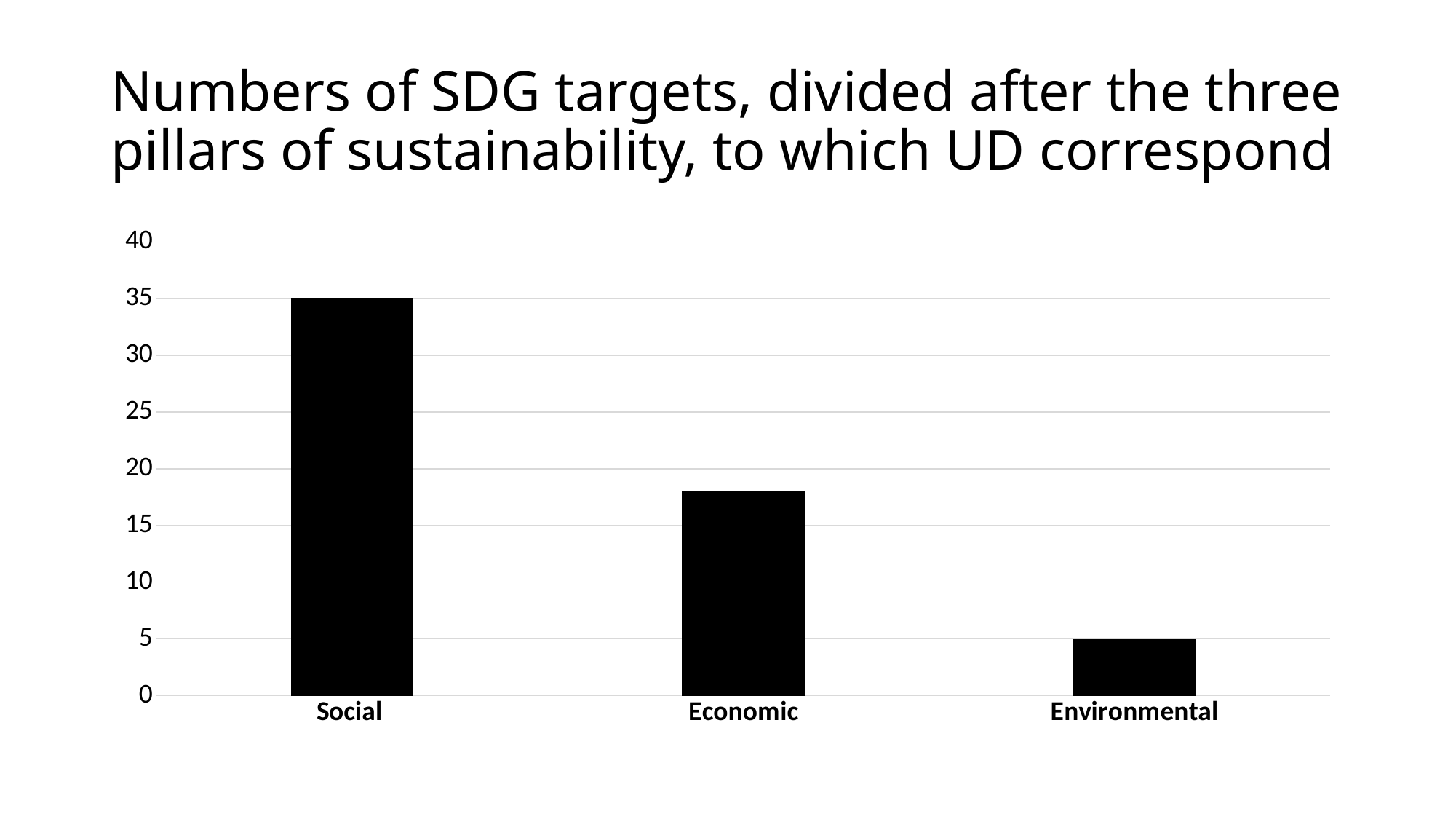
Do the values rise or fall from left to right along the x axis? fall What is the difference between the values for Social and Environmental? 30 Which category has the highest value? Social Is the value for Economic greater or less than 20? less How many categories are shown on the x axis? 3 What colour are the bars in the chart? black What is the value for Environmental? 5 Which category has the lowest value? Environmental What is the value for Social? 35 Is the value for Economic greater or less than 15? greater What kind of chart is shown on the slide? bar chart Which is larger, the value for Social or the value for Economic? Social